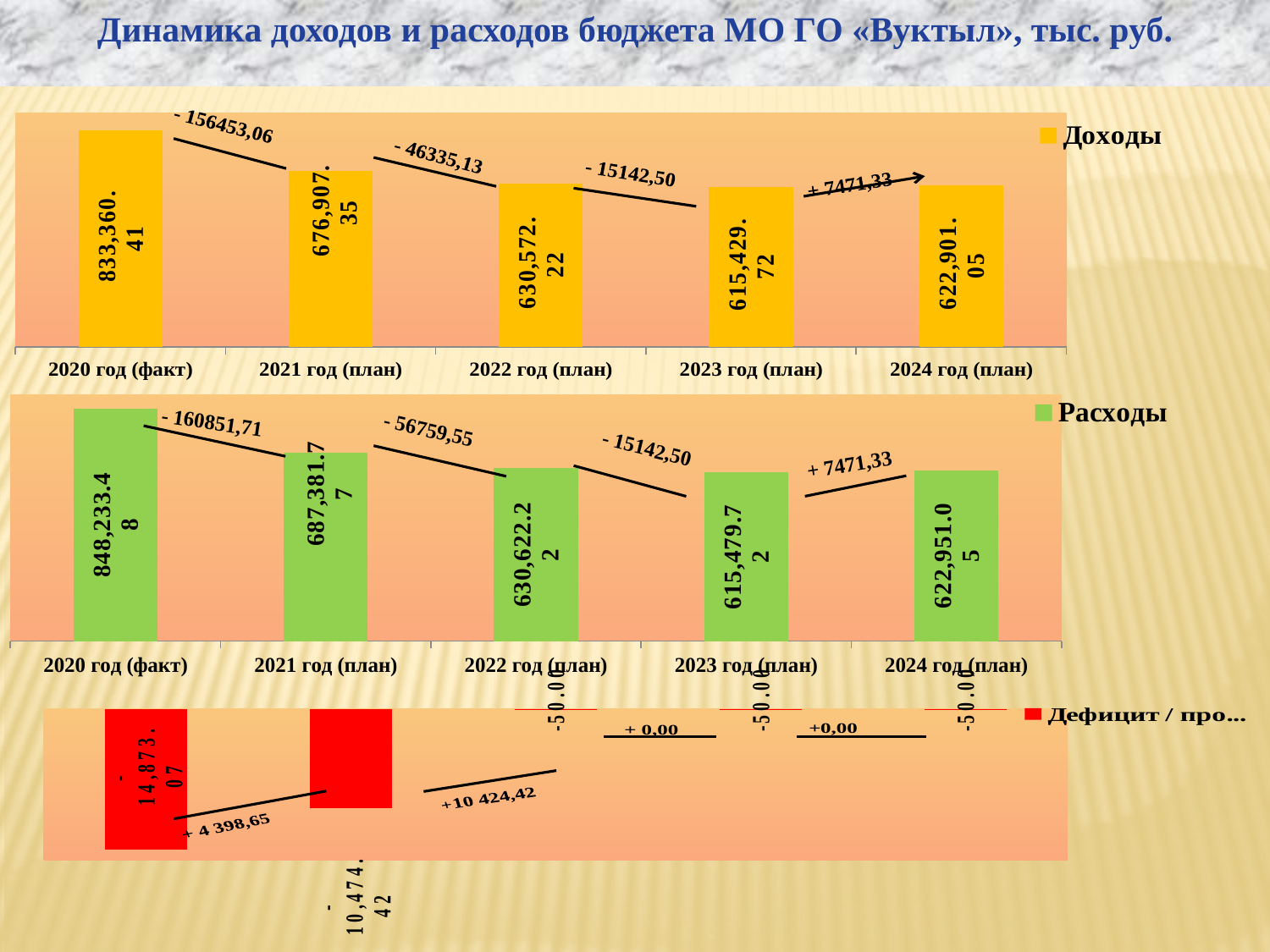
On the Доходы chart, do the values rise or fall from 2020 год (факт) to 2023 год (план)? fall How many years (categories) are shown on the Доходы chart? 5 On the Доходы chart, what is the difference between 2020 год (факт) and 2021 год (план), as annotated on the chart? - 156453,06 What type of chart is the Расходы chart? bar chart On the Доходы chart, which year has the highest value? 2020 год (факт) On the Расходы chart, what is the value for 2021 год (план)? 687,381.77 On the Доходы chart, what is the value for 2020 год (факт)? 833,360.41 On the Расходы chart, what is the value for 2023 год (план)? 615,479.72 On the Дефицит / профицит chart at the bottom, what is the value for 2020 год (факт)? -14,873.07 On the Расходы chart, which is larger: the value for 2022 год (план) or 2024 год (план)? 2022 год (план) On the Доходы chart, what is the value for 2024 год (план)? 622,901.05 On the Расходы chart, which year has the lowest value? 2023 год (план)